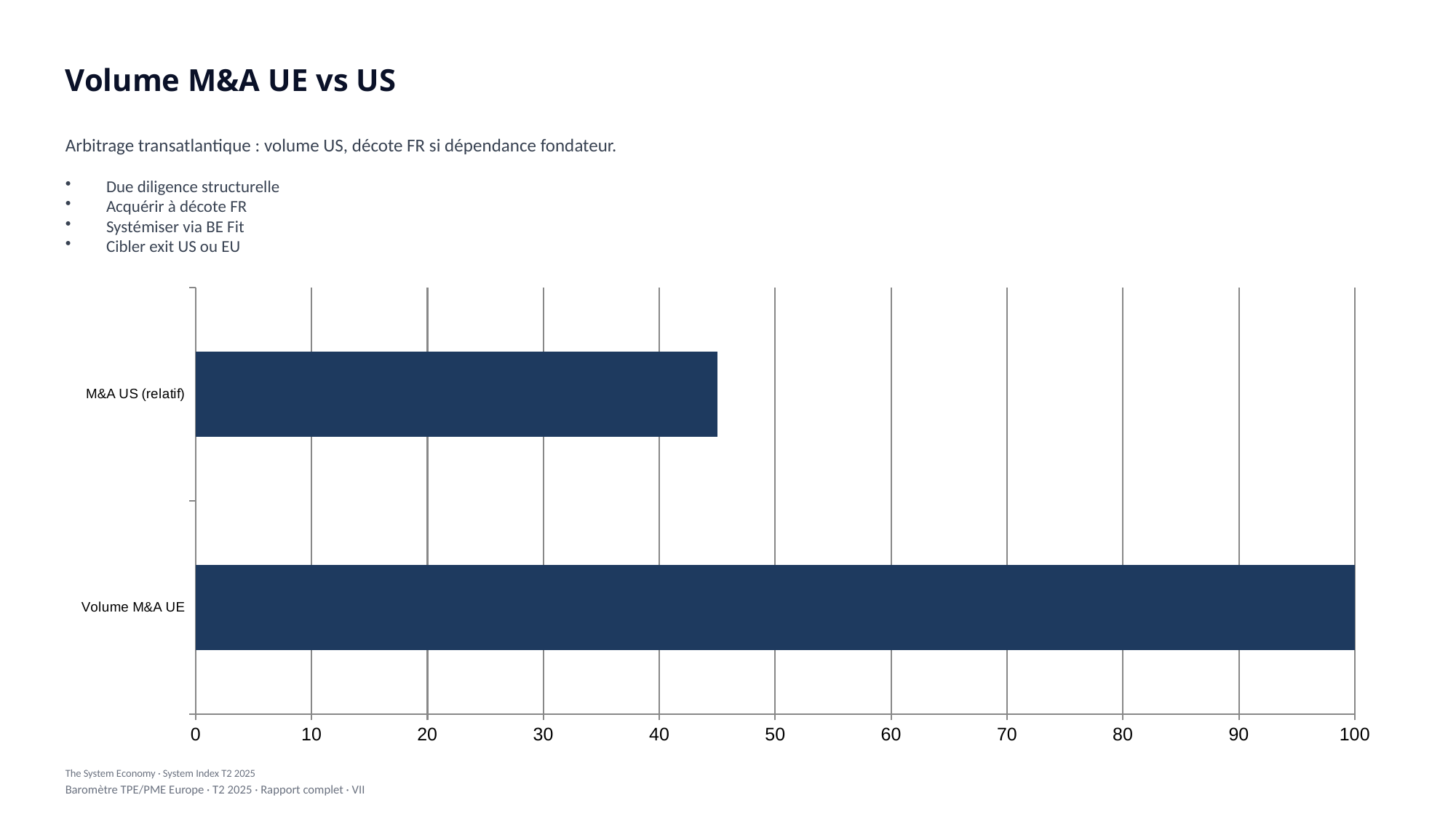
Is the value for Volume M&A UE greater or less than 90? greater What is the title of the chart slide? Volume M&A UE vs US How many categories does the chart show? 2 What is the maximum value shown on the horizontal axis? 100 Which is larger, the value for Volume M&A UE or the value for M&A US (relatif)? Volume M&A UE Which category has the lowest value? M&A US (relatif) Is the value for M&A US (relatif) greater or less than 40? greater What is the value for Volume M&A UE? 100 What kind of chart is shown on the slide? bar chart Is the value for M&A US (relatif) greater or less than 50? less Which category has the highest value? Volume M&A UE